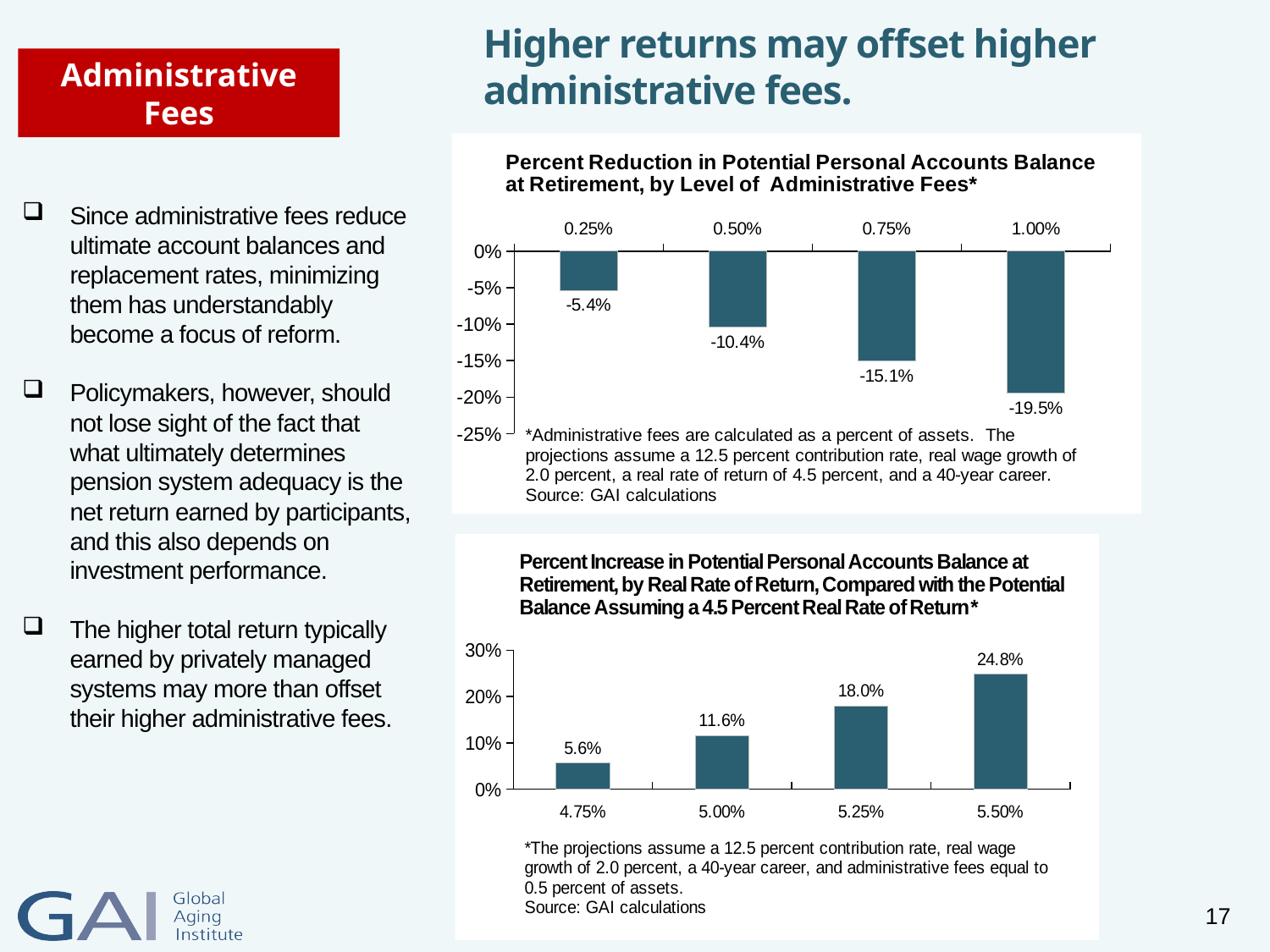
In the bottom chart (Percent Increase in Potential Personal Accounts Balance at Retirement, by Real Rate of Return), which real rate of return has the lowest value? 4.75% In the bottom chart (Percent Increase in Potential Personal Accounts Balance at Retirement, by Real Rate of Return), do the values rise or fall as the real rate of return increases along the x axis? Rise In the top chart (Percent Reduction in Potential Personal Accounts Balance at Retirement), what is the value for administrative fees of 1.00%? -19.5% In the bottom chart (Percent Increase in Potential Personal Accounts Balance at Retirement, by Real Rate of Return), what is the difference between the values for 5.50% and 5.00%? 13.2 percentage points In the top chart (Percent Reduction in Potential Personal Accounts Balance at Retirement), do the values become more negative or less negative as the fee level increases along the x axis? More negative In the top chart (Percent Reduction in Potential Personal Accounts Balance at Retirement), which level of administrative fees has the largest reduction? 1.00% In the bottom chart (Percent Increase in Potential Personal Accounts Balance at Retirement, by Real Rate of Return), what is the value for a 5.25% real rate of return? 18.0% In the top chart (Percent Reduction in Potential Personal Accounts Balance at Retirement), what is the value for administrative fees of 0.50%? -10.4% In the top chart (Percent Reduction in Potential Personal Accounts Balance at Retirement), how many levels of administrative fees are shown? 4 In the bottom chart (Percent Increase in Potential Personal Accounts Balance at Retirement, by Real Rate of Return), is the value for 5.00% greater or less than 10%? greater In the top chart (Percent Reduction in Potential Personal Accounts Balance at Retirement), what is the difference between the values for 0.75% and 0.25% fees? 9.7 percentage points What type of chart is the bottom chart (Percent Increase in Potential Personal Accounts Balance at Retirement, by Real Rate of Return)? Bar chart